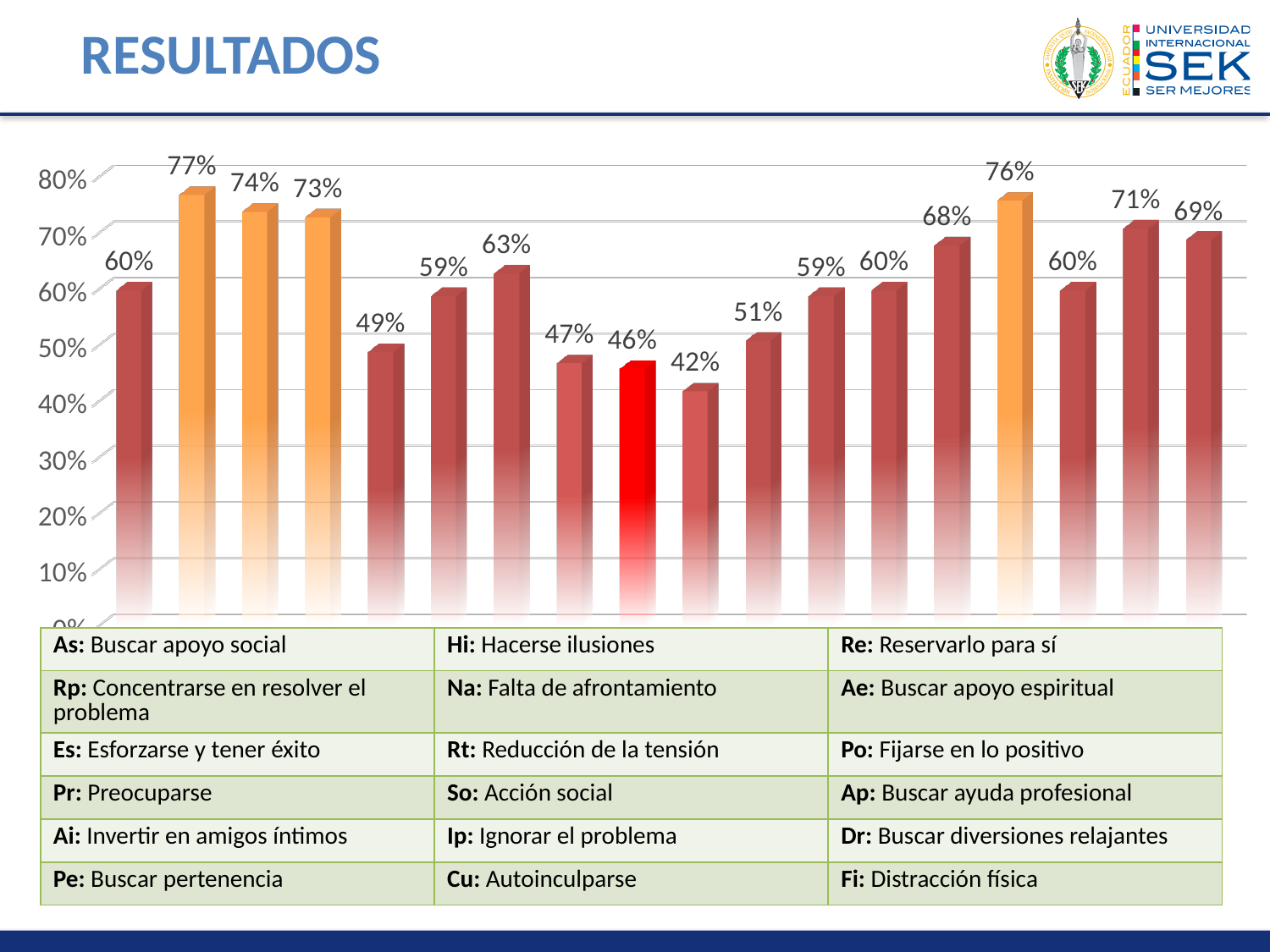
What is the value of the first (leftmost) bar in the chart? 60% How many bars are plotted in the chart? 18 What is the highest value shown in the chart? 77% How many bars in the chart are coloured orange? 4 What is the value of the last (rightmost) bar in the chart? 69% Which is larger, the second bar (77%) or the third bar (74%)? the second bar (77%) Is the value of the fifth bar from the left greater or less than 50%? less What is the lowest value shown in the chart? 42% What is the difference between the highest value (77%) and the lowest value (42%) in the chart? 35% What is the value of the bright red bar in the chart? 46% What kind of chart is shown on the slide? bar chart How many bars in the chart have values above 70%? 5